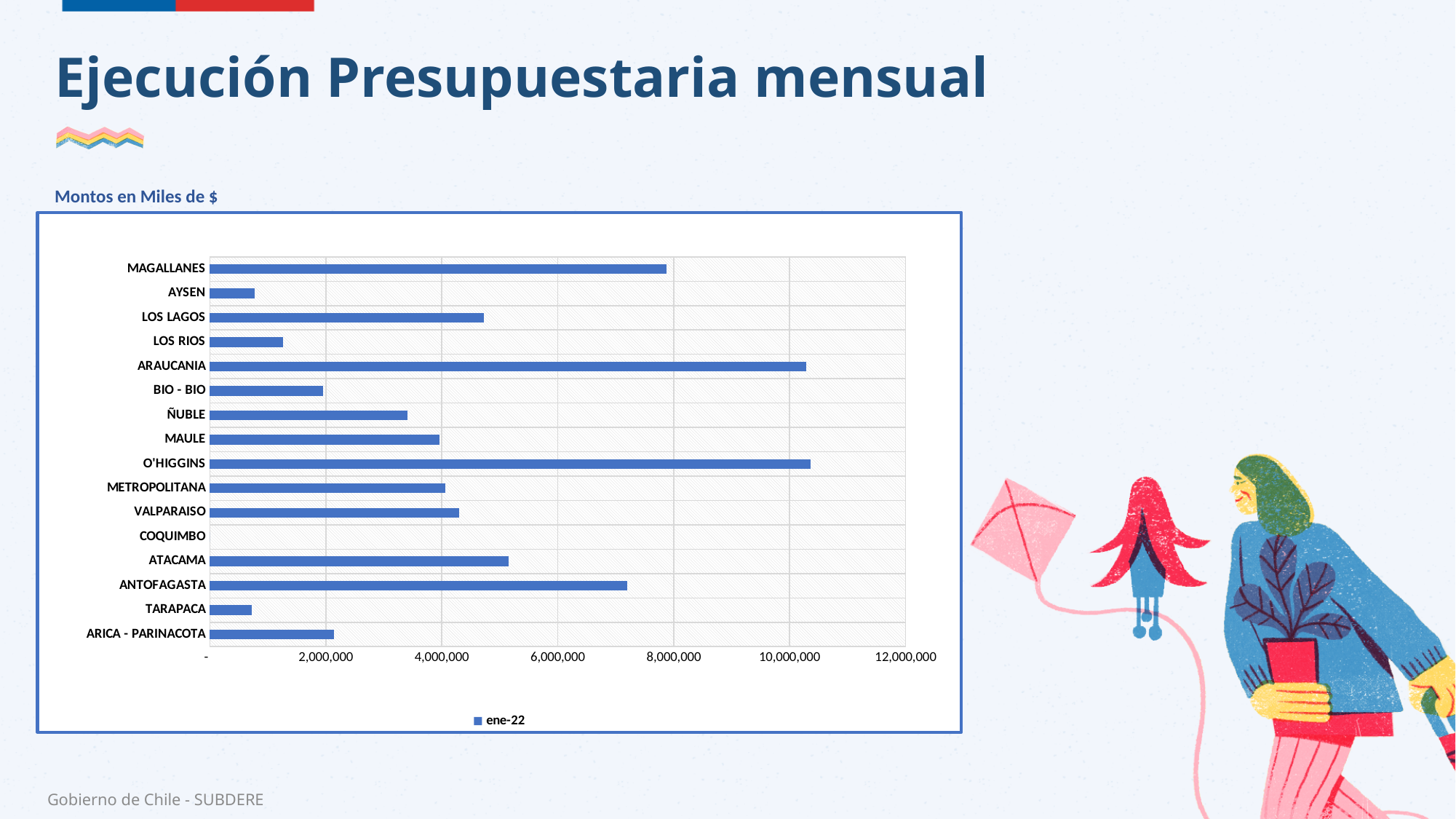
Is the value for ANTOFAGASTA greater or less than 6,000,000? greater How many series does the chart legend list? 1 Which region has no visible bar on the chart? COQUIMBO What is the name of the series shown in the chart legend? ene-22 What kind of chart is shown on the slide? bar chart Is the value for MAGALLANES greater or less than 8,000,000? less Is the value for LOS RIOS greater or less than 2,000,000? less Which has the larger value, LOS LAGOS or LOS RIOS? LOS LAGOS Which has the larger value, MAGALLANES or ANTOFAGASTA? MAGALLANES How many regions (categories) are listed on the chart? 16 What unit note is printed above the chart? Montos en Miles de $